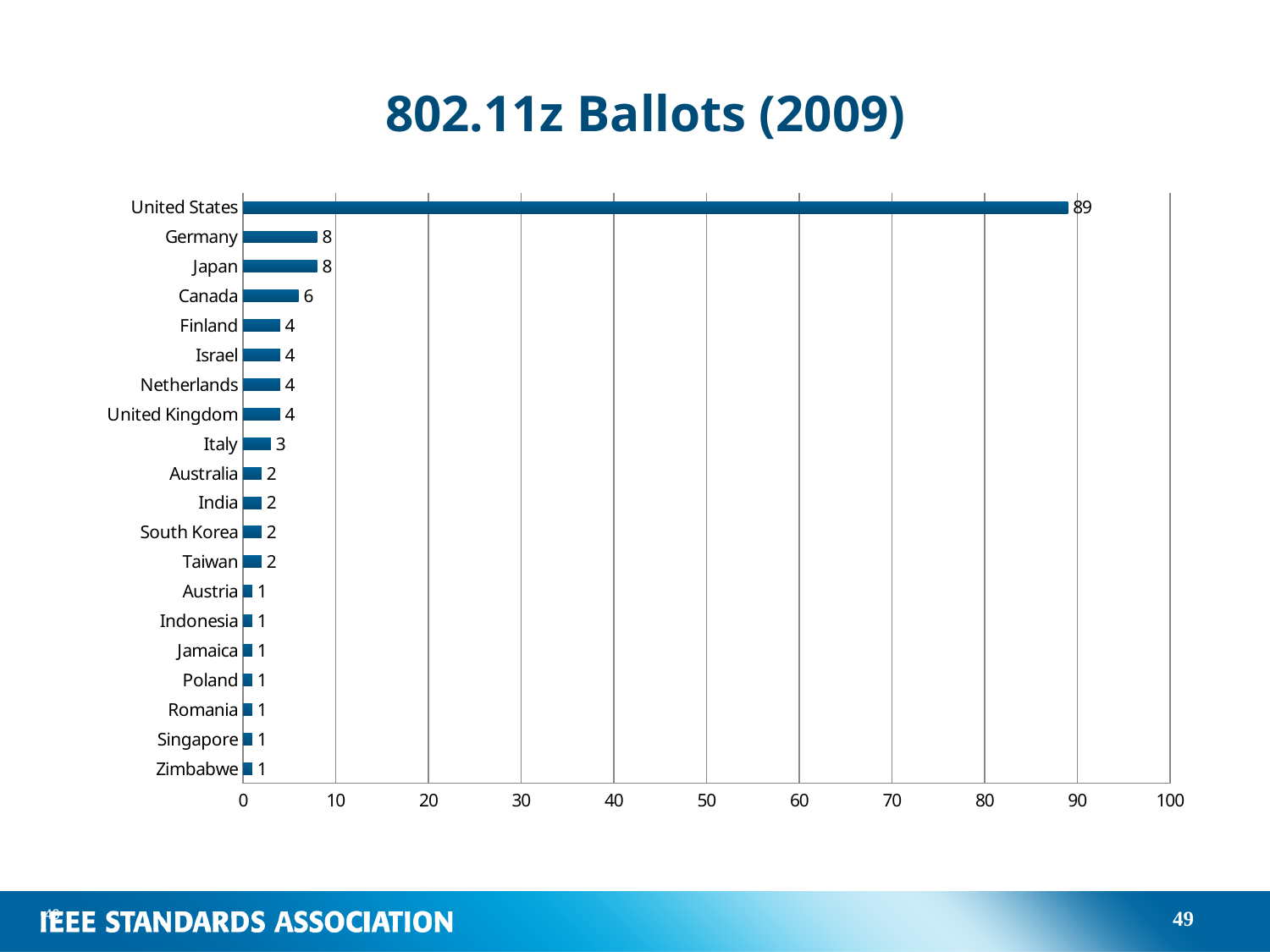
What is the value for Canada? 6 Which is larger, the value for Japan or the value for Finland? Japan How many countries are shown in the chart? 20 What is the value for United States? 89 What is the difference between the values for Canada and Taiwan? 4 What is the value for Italy? 3 What kind of chart is shown on the slide? bar chart What is the title of the chart? 802.11z Ballots (2009) What is the value for Netherlands? 4 Is the value for United States greater or less than 80? greater What is the difference between the values for United States and Germany? 81 Which country has the highest value? United States